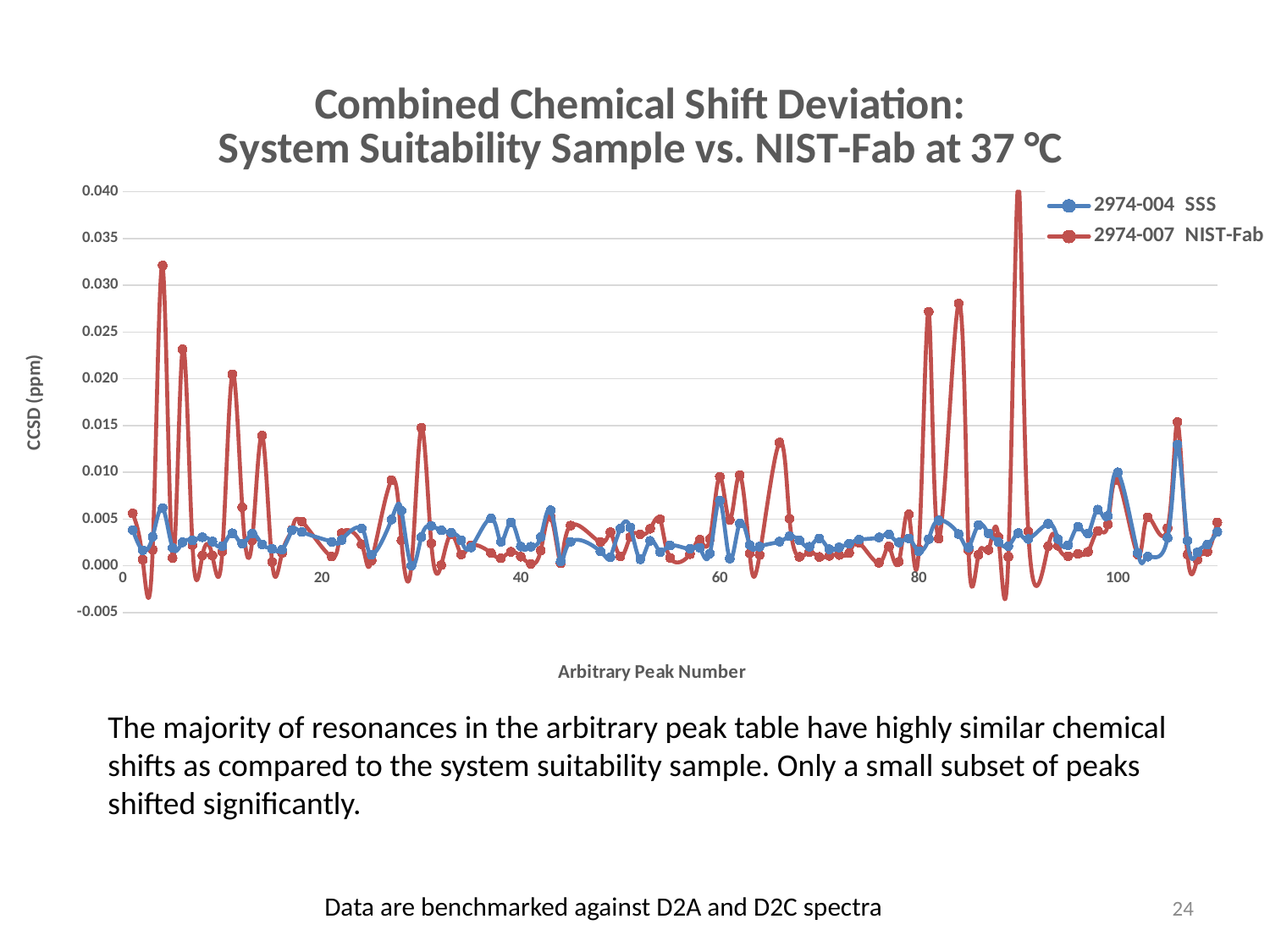
Does the 2974-007 NIST-Fab series ever drop below 0.000 on the chart? yes Is the highest peak of the 2974-007 NIST-Fab series greater or less than 0.035? greater Which series reaches the highest CCSD value on the chart, 2974-004 SSS or 2974-007 NIST-Fab? 2974-007 NIST-Fab What is the maximum value shown on the y axis? 0.040 Is the 2974-007 NIST-Fab peak near peak number 4 greater or less than 0.030? greater Which series shows the larger spikes across the peak numbers, 2974-004 SSS or 2974-007 NIST-Fab? 2974-007 NIST-Fab What are the two series named in the legend? 2974-004 SSS and 2974-007 NIST-Fab What kind of chart is shown on the slide? line chart How many series does the legend list? 2 What is the title of the y axis? CCSD (ppm)